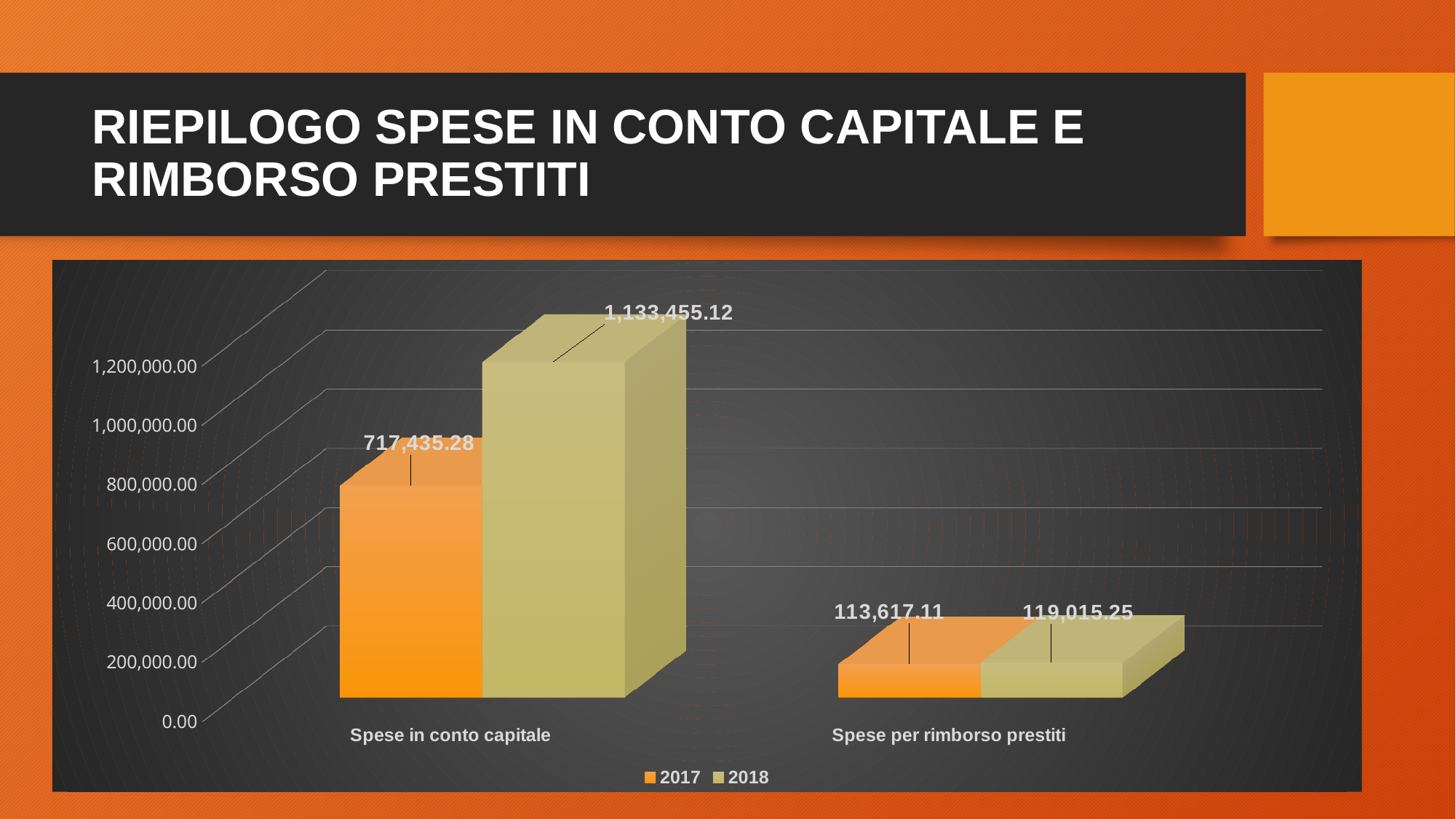
What is the 2018 value for Spese per rimborso prestiti? 119,015.25 What is the difference between the 2018 and 2017 values for Spese per rimborso prestiti? 5,398.14 How many series does the legend list? 2 Which bar has the highest value on the chart? Spese in conto capitale, 2018 What is the 2017 value for Spese per rimborso prestiti? 113,617.11 What is the difference between the 2018 and 2017 values for Spese in conto capitale? 416,019.84 How many categories are shown on the x axis? 2 What kind of chart is shown on the slide? Bar chart Which bar has the lowest value on the chart? Spese per rimborso prestiti, 2017 What is the 2017 value for Spese in conto capitale? 717,435.28 Which is larger: the 2017 value for Spese in conto capitale or the 2017 value for Spese per rimborso prestiti? Spese in conto capitale What is the 2018 value for Spese in conto capitale? 1,133,455.12